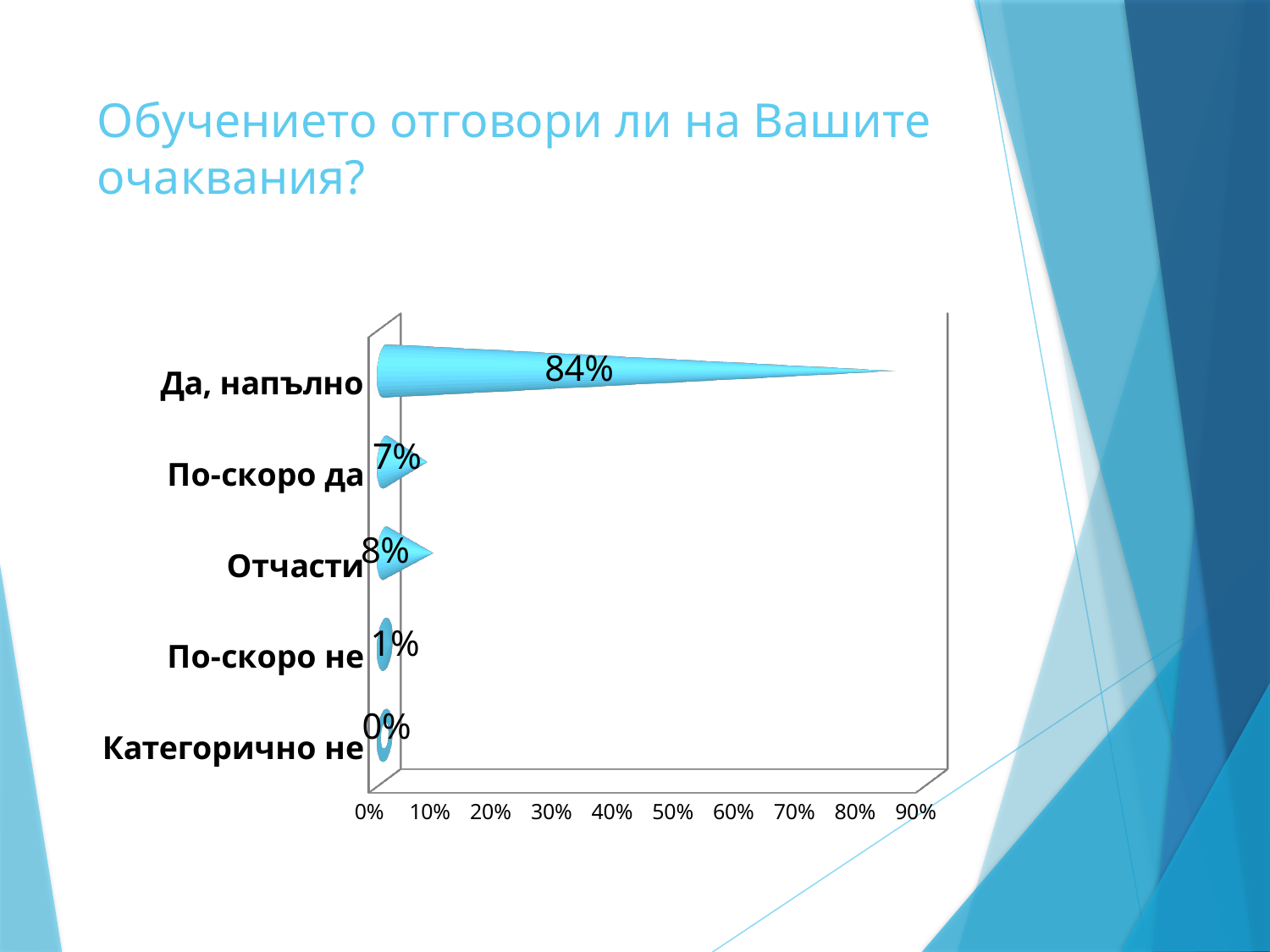
Which category has the lowest value? Категорично не What is the difference between the values for "Да, напълно" and "Отчасти"? 76% What kind of chart is shown on the slide? Bar chart Which is larger, the value for "Отчасти" or the value for "По-скоро да"? Отчасти What is the value for "По-скоро не"? 1% Which category has the highest value? Да, напълно What is the value for "Категорично не"? 0% What is the value for "По-скоро да"? 7% What is the value for "Да, напълно"? 84% What is the title of the slide? Обучението отговори ли на Вашите очаквания? How many categories are shown in the chart? 5 What is the value for "Отчасти"? 8%